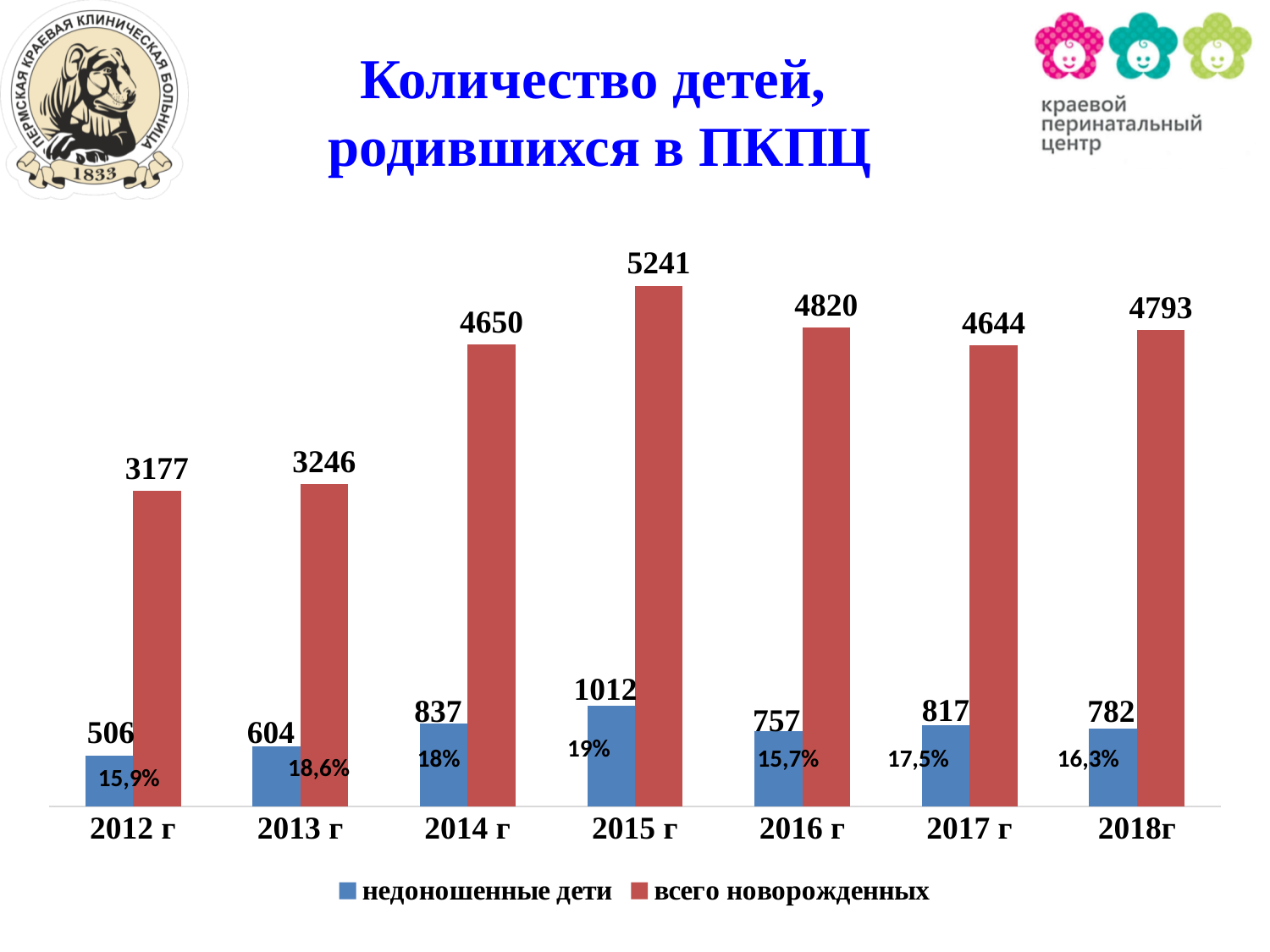
How many years are shown on the x axis? 7 What is the value for всего новорожденных in 2015 г? 5241 What colour are the bars for всего новорожденных? red What kind of chart is shown on the slide? bar chart What is the difference between всего новорожденных in 2015 г and in 2014 г? 591 How many series does the legend list? 2 Which year has the lowest value for недоношенные дети? 2012 г What is the value for недоношенные дети in 2012 г? 506 Which year has the highest value for всего новорожденных? 2015 г Which is larger: недоношенные дети in 2017 г or in 2018 г? 2017 г Does the value for всего новорожденных rise or fall from 2012 г to 2015 г? rise What percentage label is shown inside the недоношенные дети bar for 2013 г? 18,6%